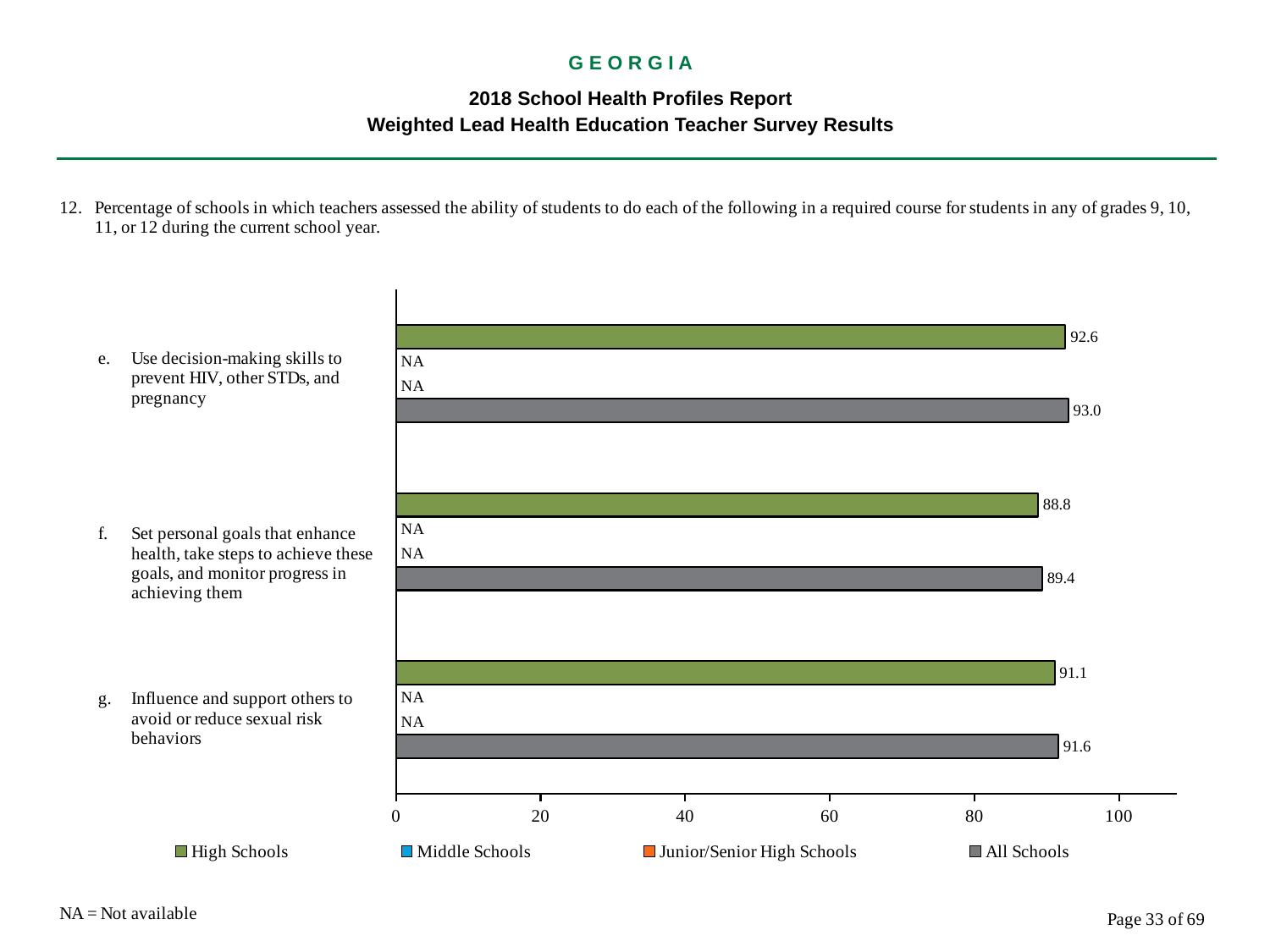
What is the All Schools value for 'Set personal goals that enhance health, take steps to achieve these goals, and monitor progress in achieving them'? 89.4 What is the High Schools value for 'Influence and support others to avoid or reduce sexual risk behaviors'? 91.1 Which is larger: the High Schools value for 'Set personal goals...' or the High Schools value for 'Influence and support others...'? Influence and support others to avoid or reduce sexual risk behaviors Is the High Schools value for 'Set personal goals that enhance health...' greater or less than 80? greater What is the All Schools value for 'Use decision-making skills to prevent HIV, other STDs, and pregnancy'? 93.0 Which category has the lowest All Schools value? Set personal goals that enhance health, take steps to achieve these goals, and monitor progress in achieving them What is the High Schools value for 'Use decision-making skills to prevent HIV, other STDs, and pregnancy'? 92.6 How many series does the legend list? 4 How many categories are shown on the chart? 3 What kind of chart is shown on the slide? bar chart What is the difference between the All Schools and High Schools values for 'Influence and support others to avoid or reduce sexual risk behaviors'? 0.5 Which category has the highest High Schools value? Use decision-making skills to prevent HIV, other STDs, and pregnancy